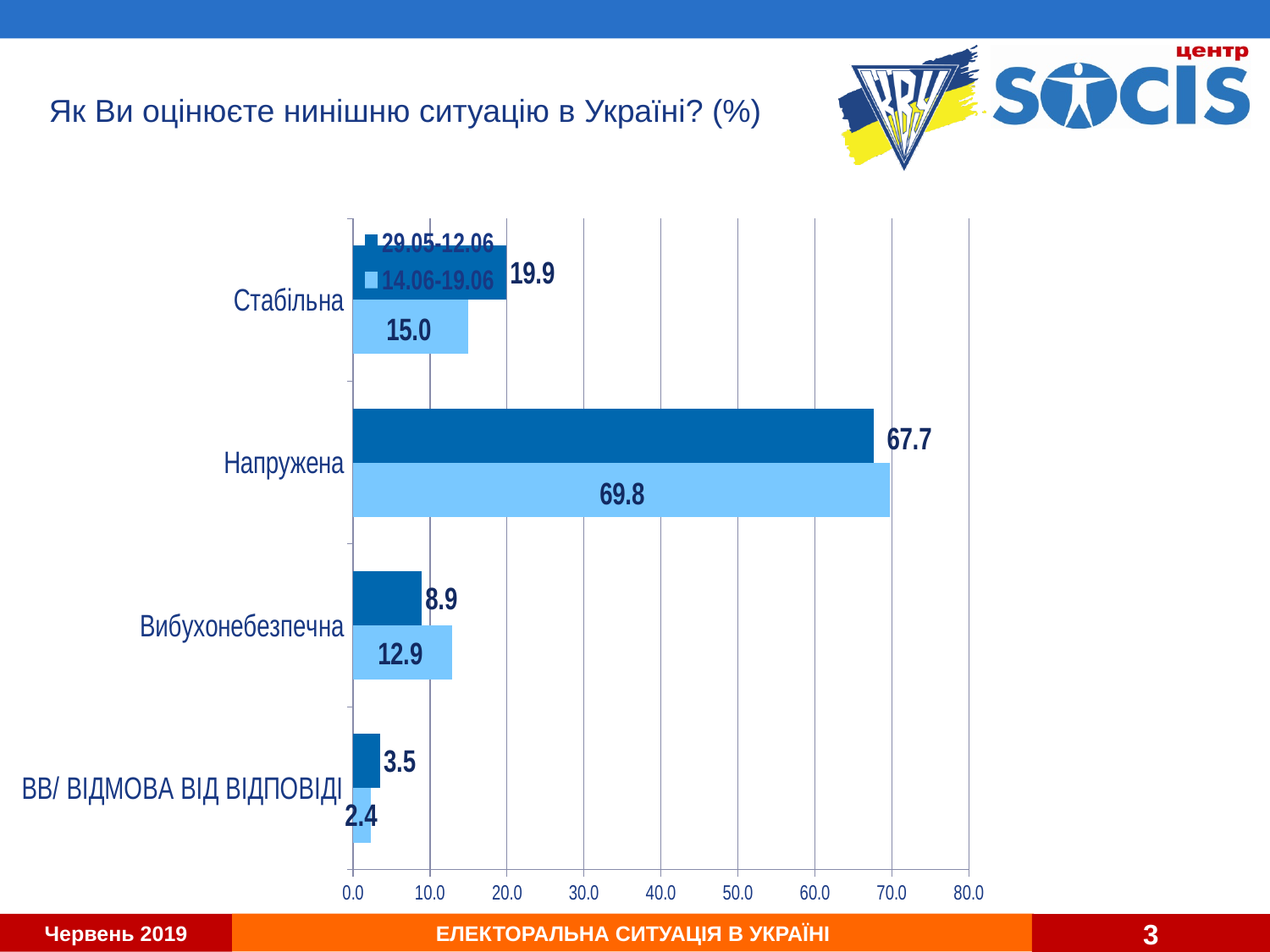
What is the value for Напружена in the 14.06-19.06 series? 69.8 Which category has the lowest value in the 29.05-12.06 series? ВВ/ ВІДМОВА ВІД ВІДПОВІДІ What is the difference between the 14.06-19.06 and 29.05-12.06 values for Напружена? 2.1 What kind of chart is shown on the slide? Bar chart What is the value for Стабільна in the 29.05-12.06 series? 19.9 Which category has the highest value in the 14.06-19.06 series? Напружена For Стабільна, which series has the larger value: 29.05-12.06 or 14.06-19.06? 29.05-12.06 How many series does the legend list? 2 How many categories are shown on the chart? 4 What is the value for Вибухонебезпечна in the 14.06-19.06 series? 12.9 What is the value for ВВ/ ВІДМОВА ВІД ВІДПОВІДІ in the 29.05-12.06 series? 3.5 Is the value for Напружена in the 29.05-12.06 series greater or less than 60.0? greater